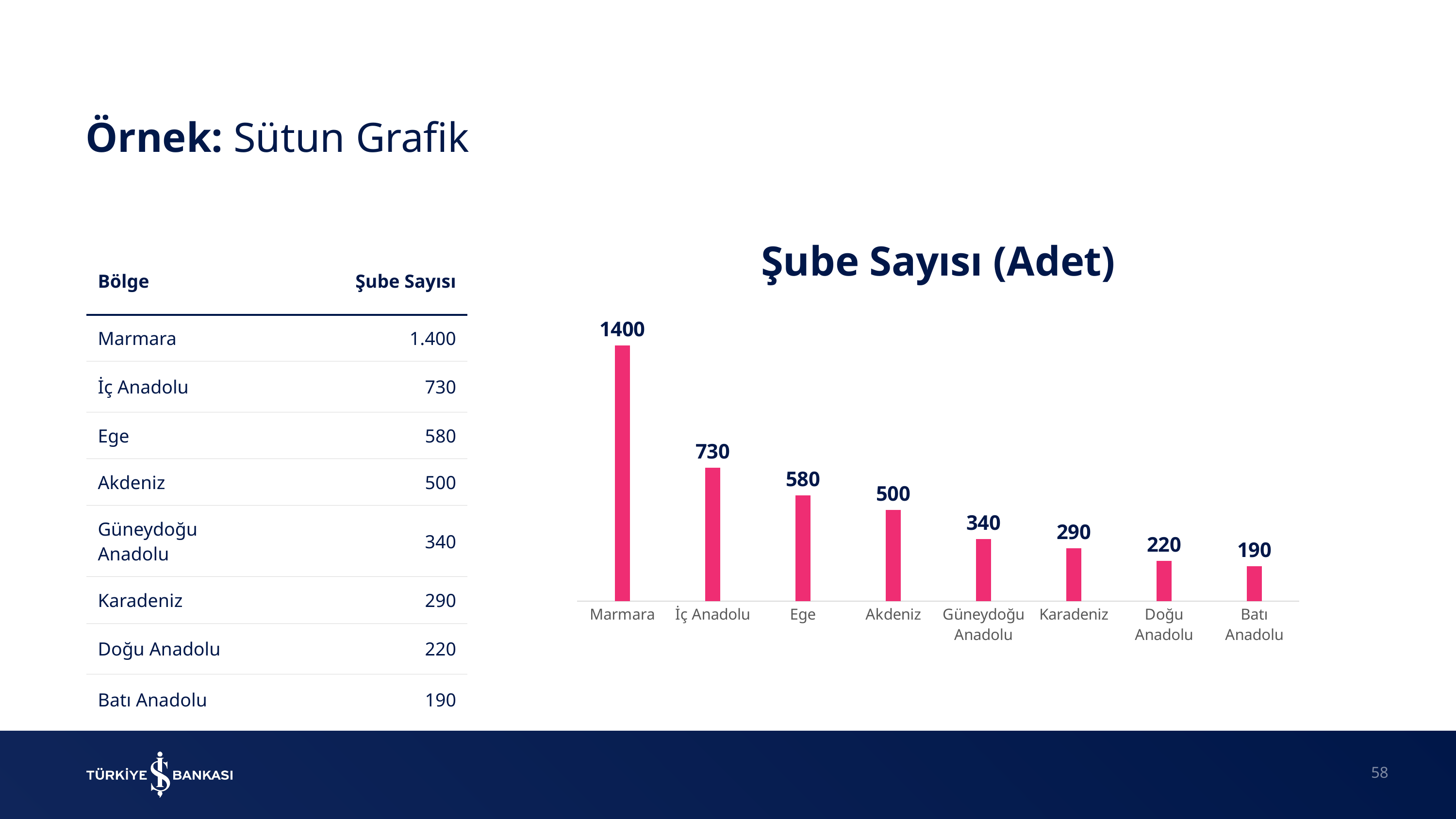
What is the difference between the values for Doğu Anadolu and Batı Anadolu? 30 What is the value for Karadeniz in the chart? 290 What is the difference between the values for Marmara and İç Anadolu? 670 Do the values rise or fall from left to right along the x axis? Fall What is the value for Marmara in the chart? 1400 Which region has the lowest number of branches in the chart? Batı Anadolu How many regions are shown in the chart? 8 What is the title of the chart? Şube Sayısı (Adet) What kind of chart is shown on the slide? Bar chart Which region has the highest number of branches in the chart? Marmara Which is larger, the value for Akdeniz or the value for Güneydoğu Anadolu? Akdeniz What is the value for Ege in the chart? 580